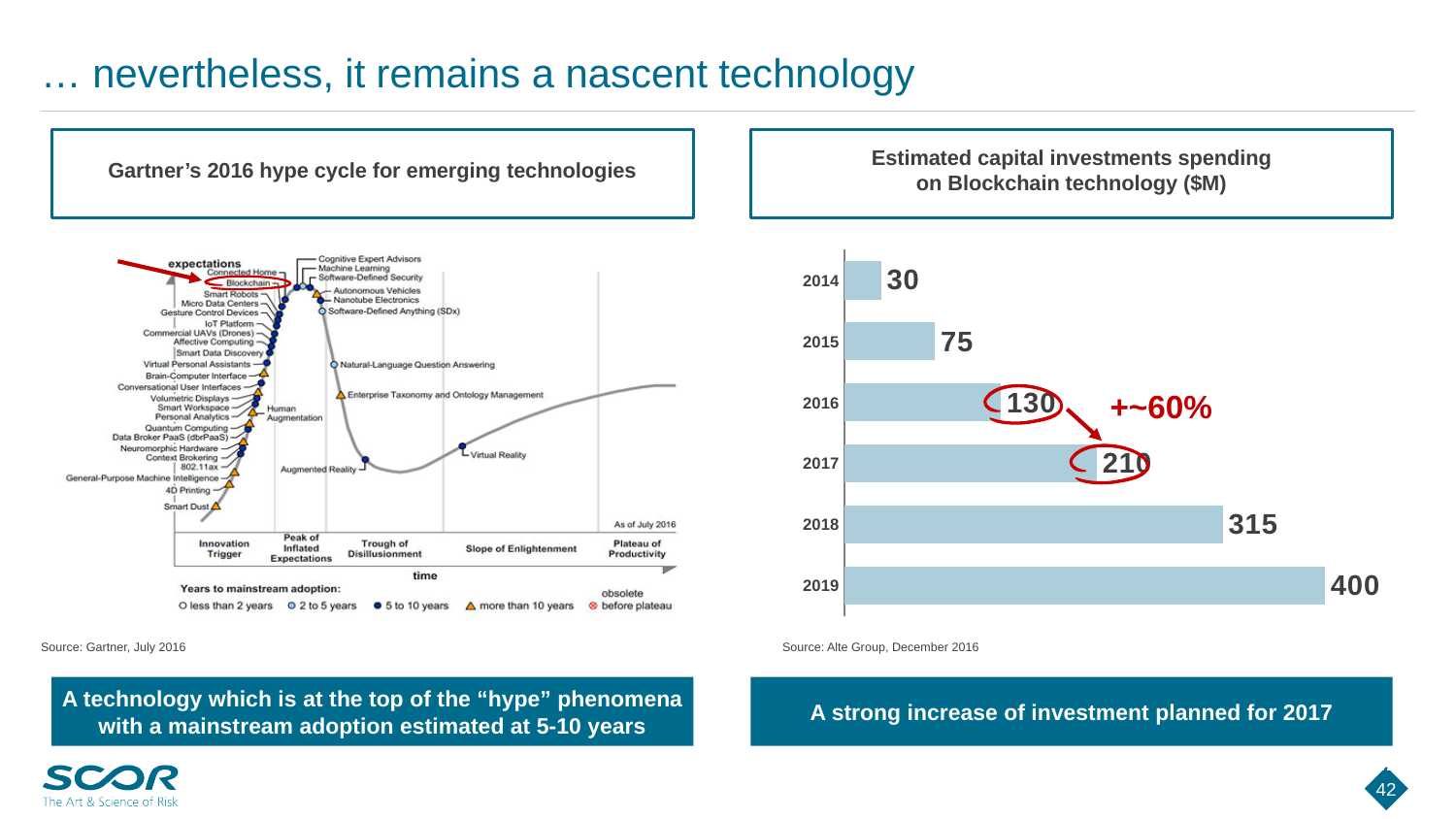
In the 'Estimated capital investments spending on Blockchain technology ($M)' chart, which is larger, the value for 2015 or the value for 2016? 2016 In the 'Estimated capital investments spending on Blockchain technology ($M)' chart, what is the value for 2019? 400 What kind of chart is the 'Estimated capital investments spending on Blockchain technology ($M)' chart? Bar chart In the 'Estimated capital investments spending on Blockchain technology ($M)' chart, what is the value for 2014? 30 In the 'Estimated capital investments spending on Blockchain technology ($M)' chart, what is the difference between the values for 2019 and 2018? 85 In the Gartner 2016 hype cycle chart on the left, in which phase of the cycle is Blockchain circled? Peak of Inflated Expectations In the 'Estimated capital investments spending on Blockchain technology ($M)' chart, do the values rise or fall from 2014 to 2019? Rise In the 'Estimated capital investments spending on Blockchain technology ($M)' chart, what is the value for 2017? 210 In the 'Estimated capital investments spending on Blockchain technology ($M)' chart, which year has the lowest value? 2014 In the 'Estimated capital investments spending on Blockchain technology ($M)' chart, what is the difference between the values for 2017 and 2016? 80 In the 'Estimated capital investments spending on Blockchain technology ($M)' chart, which year has the highest value? 2019 How many years are shown in the 'Estimated capital investments spending on Blockchain technology ($M)' chart? 6